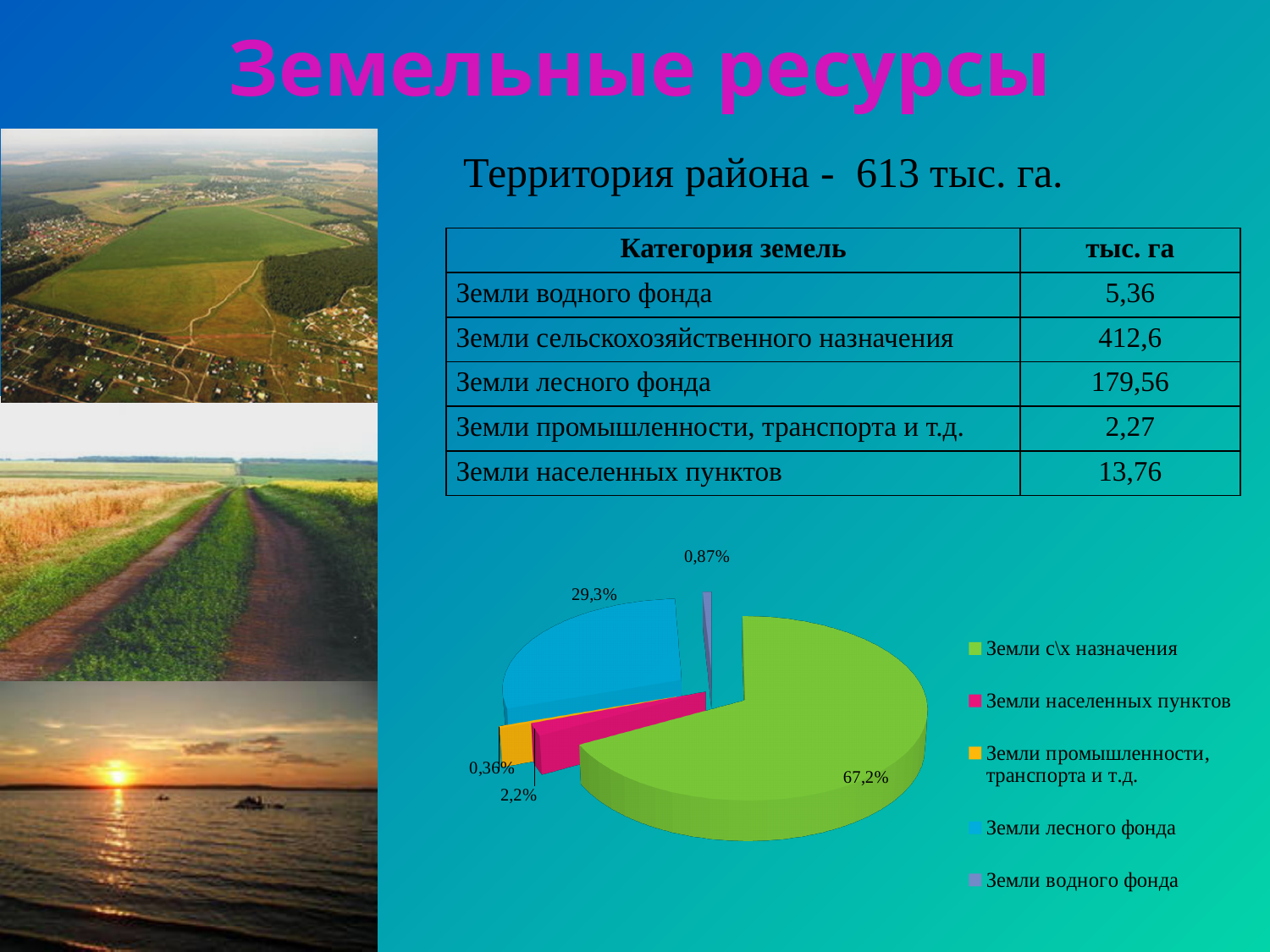
What kind of chart is shown on the slide? pie chart What colour is the Земли лесного фонда slice in the pie chart? blue What percentage is shown for Земли населенных пунктов in the pie chart? 2,2% What percentage is shown for Земли водного фонда in the pie chart? 0,87% What is the difference in percentage points between the Земли с\х назначения slice and the Земли лесного фонда slice? 37,9 What share of the pie chart is labelled for Земли с\х назначения? 67,2% Which category has the smallest slice in the pie chart? Земли промышленности, транспорта и т.д. What percentage is shown for Земли лесного фонда in the pie chart? 29,3% How many categories does the pie chart show? 5 What percentage is shown for Земли промышленности, транспорта и т.д. in the pie chart? 0,36% Which category has the largest slice in the pie chart? Земли с\х назначения Which slice is larger: Земли лесного фонда or Земли населенных пунктов? Земли лесного фонда